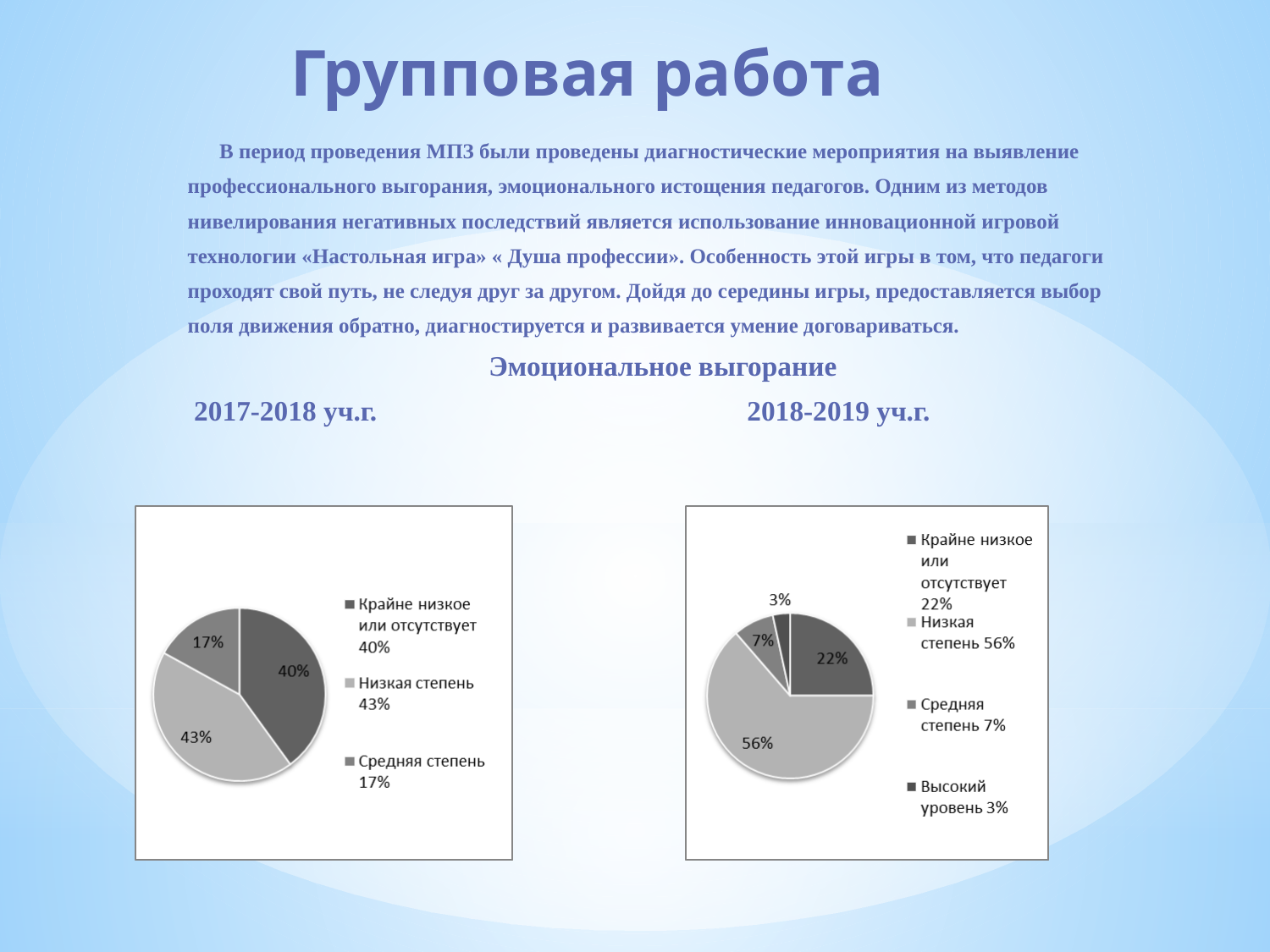
In the left pie chart (2017-2018 уч.г.), what share is labelled for Низкая степень? 43% In the right pie chart (2018-2019 уч.г.), what is the difference between the Низкая степень and Средняя степень shares? 49% In the left pie chart (2017-2018 уч.г.), what is the difference between the Низкая степень and Крайне низкое или отсутствует shares? 3% What kind of chart is shown for 2017-2018 уч.г. on the left? Pie chart In the right pie chart (2018-2019 уч.г.), what share is labelled for Высокий уровень? 3% In the left pie chart (2017-2018 уч.г.), what share is labelled for Средняя степень? 17% In the right pie chart (2018-2019 уч.г.), which category has the largest slice? Низкая степень Which is larger: the Крайне низкое или отсутствует share in the left chart (2017-2018 уч.г.) or in the right chart (2018-2019 уч.г.)? Left chart (2017-2018 уч.г.) How many slices does the left pie chart (2017-2018 уч.г.) have? 3 In the right pie chart (2018-2019 уч.г.), what share is labelled for Крайне низкое или отсутствует? 22% In the left pie chart (2017-2018 уч.г.), which category has the smallest slice? Средняя степень How many categories does the legend of the right pie chart (2018-2019 уч.г.) list? 4